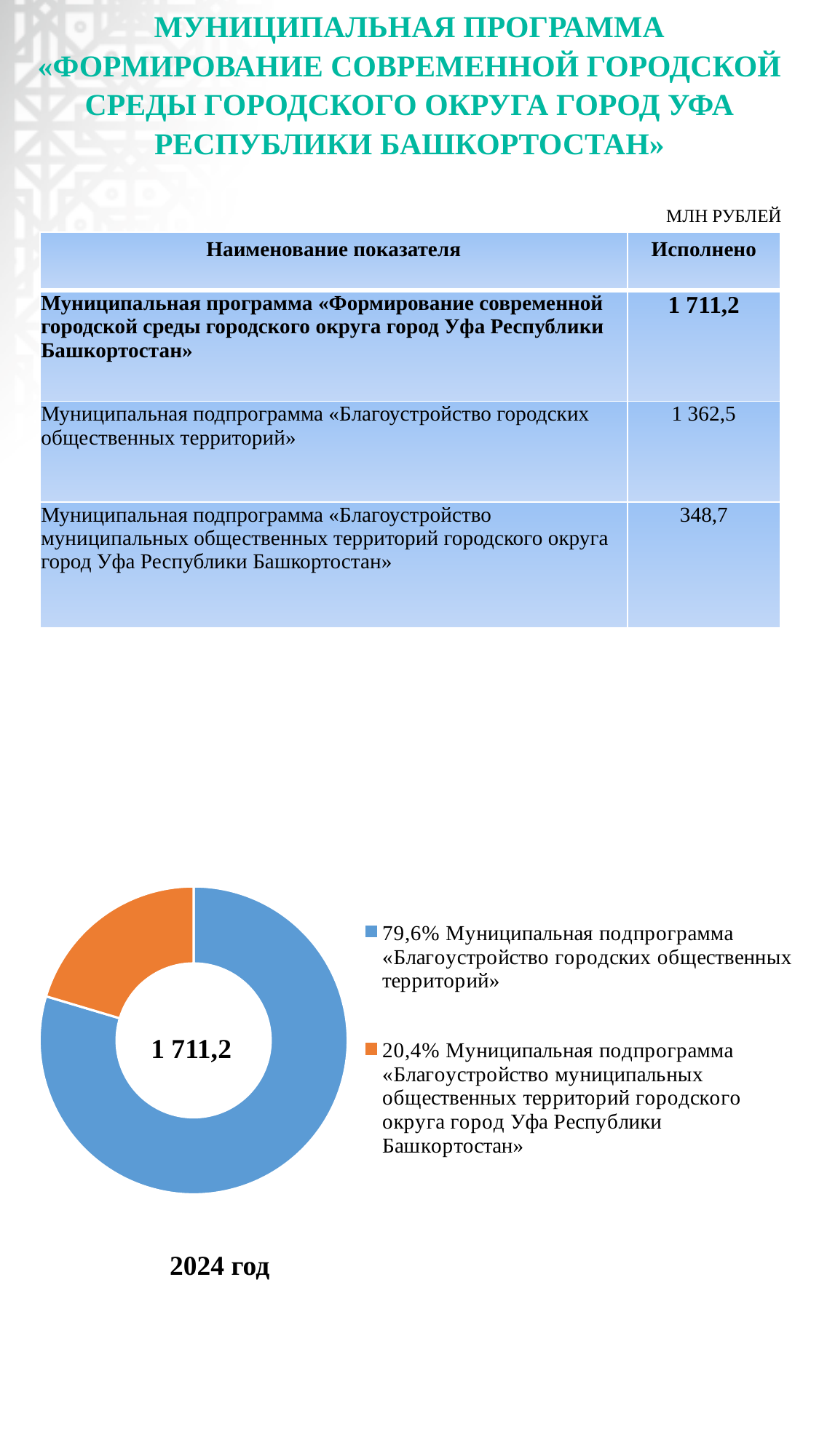
Which slice of the doughnut chart is the smallest? Муниципальная подпрограмма «Благоустройство муниципальных общественных территорий городского округа город Уфа Республики Башкортостан» Is the share of the orange slice in the doughnut chart greater or less than 25%? less What share of the doughnut chart does the subprogram «Благоустройство городских общественных территорий» take? 79,6% How many slices does the doughnut chart have? 2 Which is larger in the doughnut chart: the blue slice or the orange slice? The blue slice What kind of chart is shown at the bottom of the slide? Pie chart (doughnut) By how many percentage points does the share of «Благоустройство городских общественных территорий» exceed the share of «Благоустройство муниципальных общественных территорий городского округа город Уфа Республики Башкортостан» in the doughnut chart? 59,2% What total value is printed in the centre of the doughnut chart? 1 711,2 What year is labelled below the doughnut chart? 2024 год Which slice of the doughnut chart is the largest? Муниципальная подпрограмма «Благоустройство городских общественных территорий» What share of the doughnut chart does the subprogram «Благоустройство муниципальных общественных территорий городского округа город Уфа Республики Башкортостан» take? 20,4% What colour is the slice for «Благоустройство городских общественных территорий» in the doughnut chart? Blue